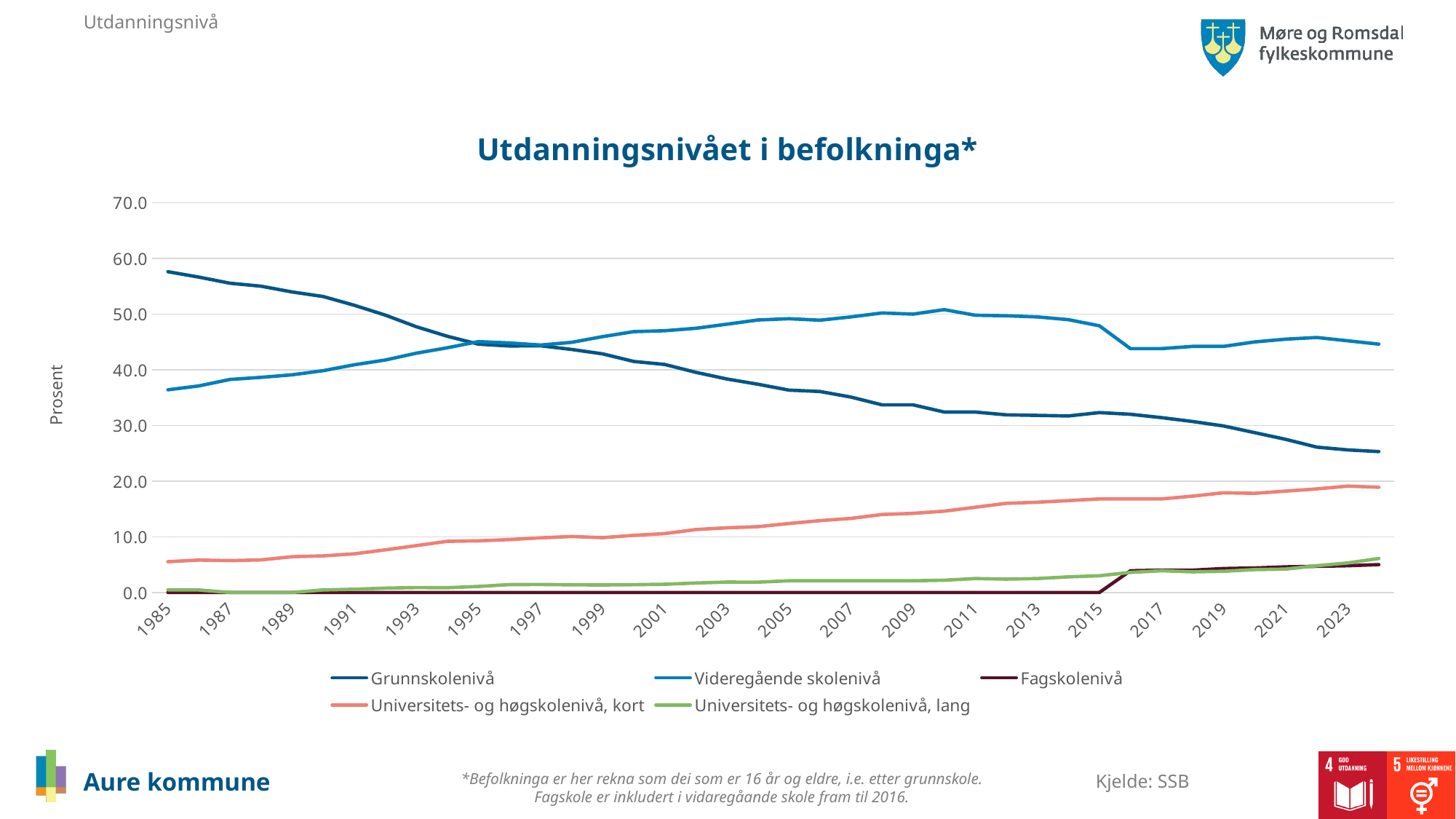
What is the title of the chart? Utdanningsnivået i befolkninga* In 1985, which is larger: Grunnskolenivå or Videregående skolenivå? Grunnskolenivå Does the Universitets- og høgskolenivå, kort line rise or fall from 1985 to 2023? rise What kind of chart is shown on the slide? line chart How many series does the legend list? 5 Is the value for Universitets- og høgskolenivå, kort in 2023 greater or less than 10? greater Is the value for Grunnskolenivå in 1985 greater or less than 50? greater What is the label on the y axis? Prosent Which series has the highest value in 2023? Videregående skolenivå Does the Grunnskolenivå line rise or fall from 1985 to 2023? fall In 2023, which is larger: Videregående skolenivå or Grunnskolenivå? Videregående skolenivå Is the value for Videregående skolenivå in 1985 greater or less than 40? less